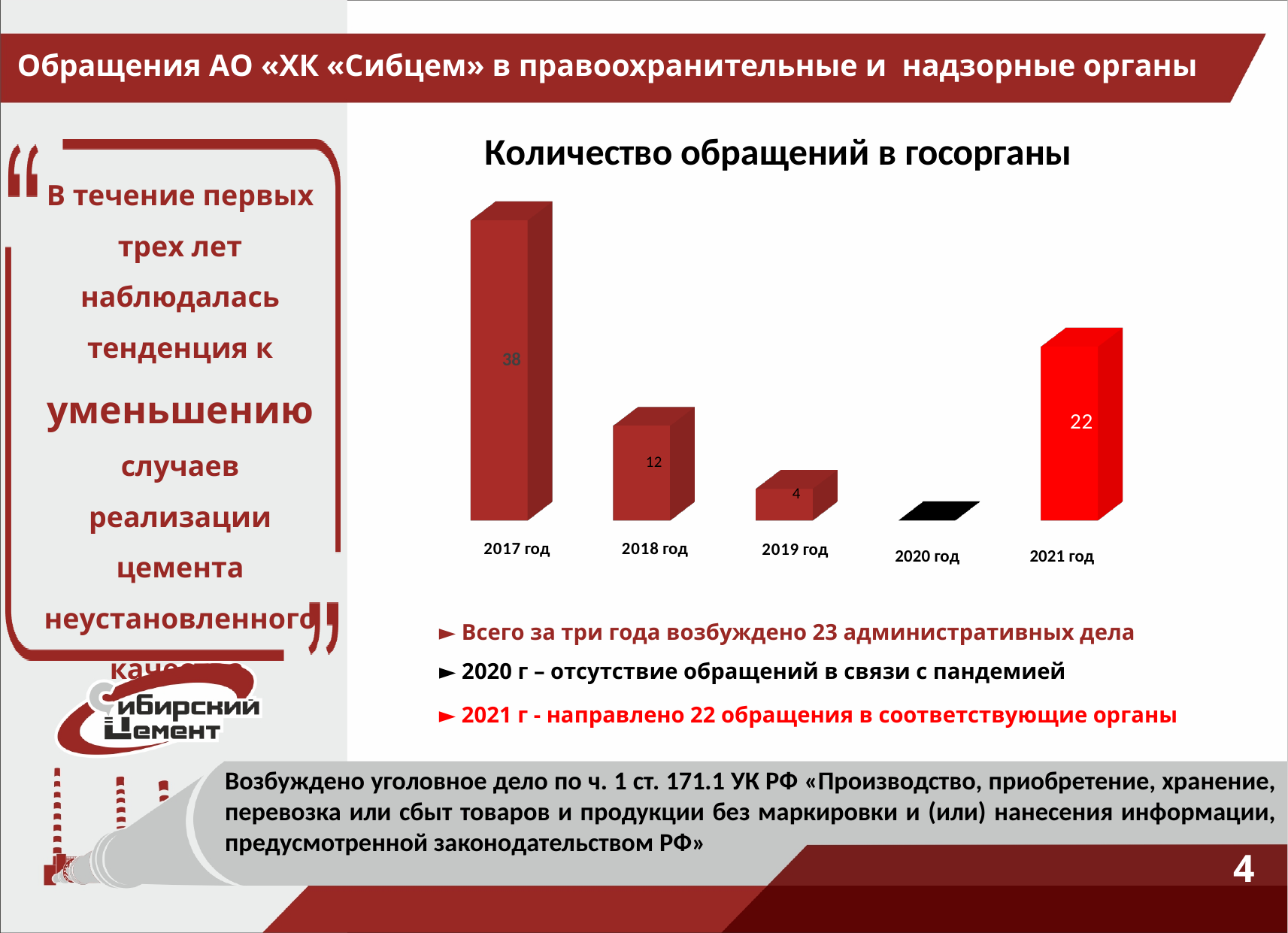
What is the value for 2018 год? 12 What is the value for 2019 год? 4 What is the value for 2017 год? 38 Which is larger, the value for 2021 год or the value for 2018 год? 2021 год What is the difference between the values for 2021 год and 2019 год? 18 How many years are shown on the chart? 5 What kind of chart is shown on the slide? bar chart Which year has the lowest number of appeals? 2020 год What is the value for 2021 год? 22 Do the values rise or fall from 2017 год to 2019 год? fall Which year has the highest number of appeals? 2017 год What is the difference between the values for 2017 год and 2018 год? 26